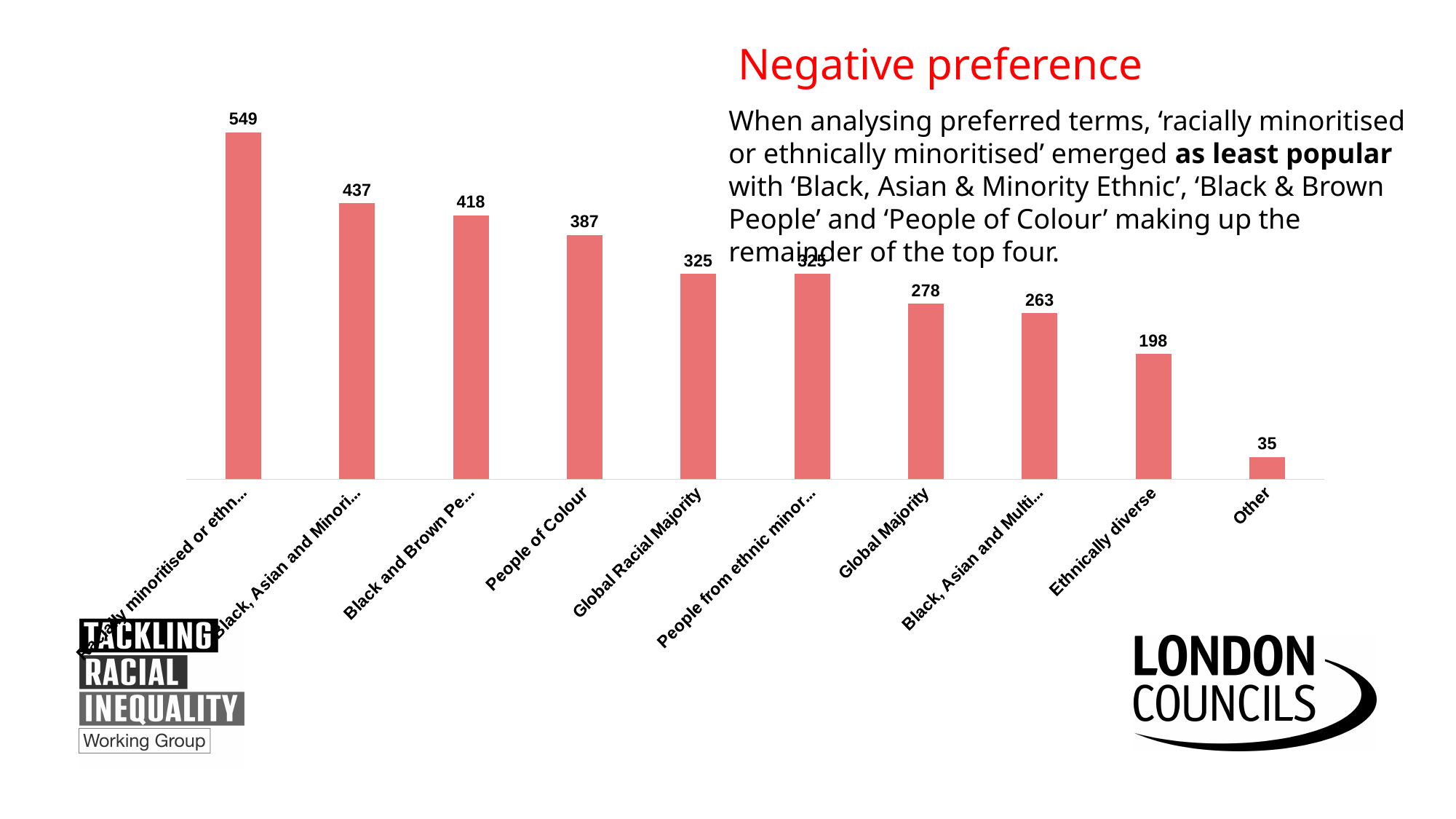
How many bars are shown on the chart? 10 What is the value for Ethnically diverse? 198 What is the value for Global Majority? 278 What is the value for People of Colour? 387 What is the highest value shown on the chart? 549 What is the value for Other? 35 Which is larger, the value for Global Majority or the value for Ethnically diverse? Global Majority What kind of chart is shown on the slide? Bar chart What is the difference between the values for People of Colour and Global Racial Majority? 62 Which category has the lowest value? Other What is the value for Global Racial Majority? 325 What is the difference between the values for Global Majority and Ethnically diverse? 80